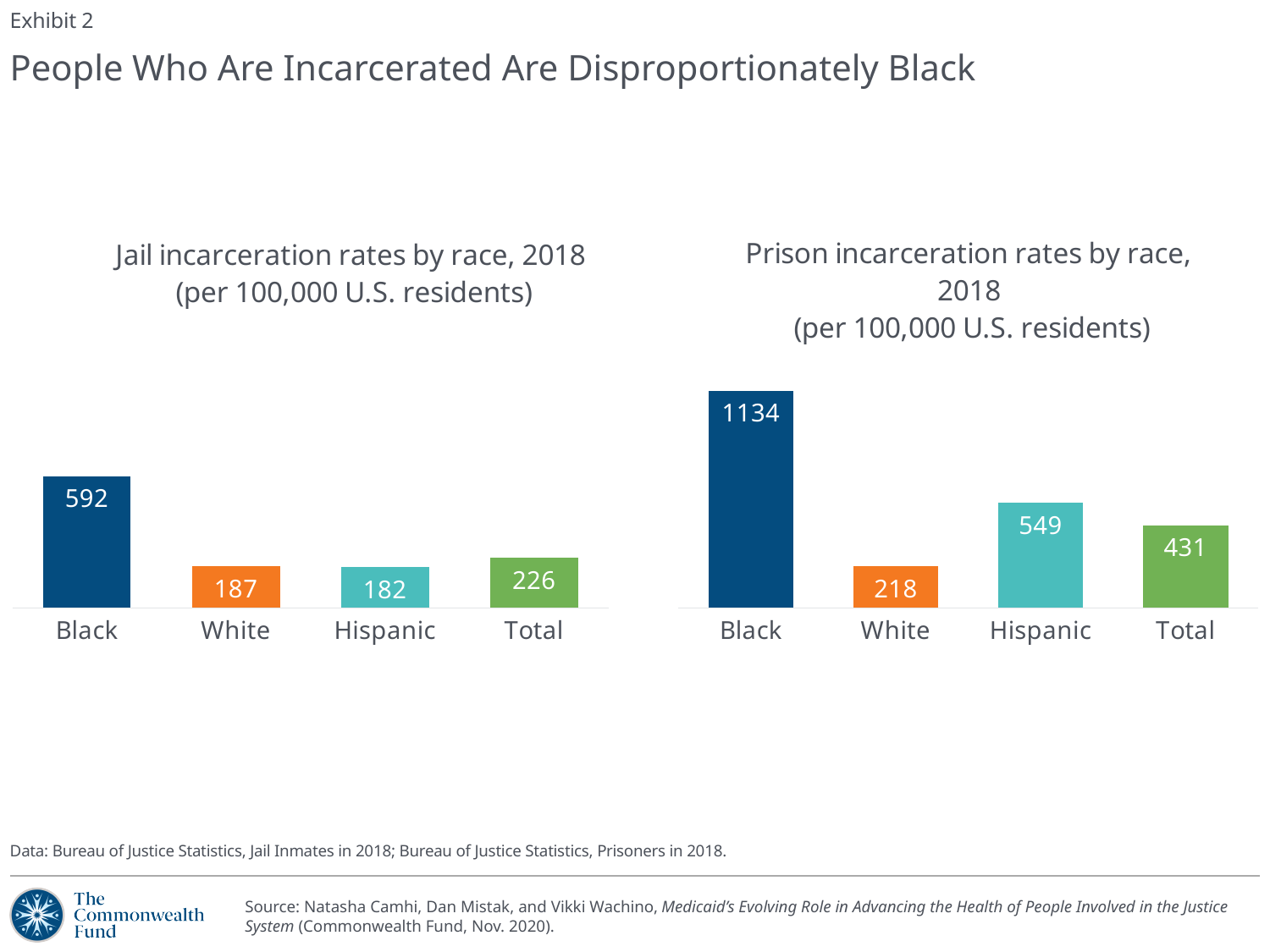
In the prison incarceration rates chart, which is larger, the value for Hispanic or the value for Total? Hispanic In the prison incarceration rates chart, which category has the highest value? Black In the prison incarceration rates chart, which category has the lowest value? White In the prison incarceration rates chart, what is the value for Hispanic? 549 In the prison incarceration rates chart, what is the difference between the values for Black and White? 916 In the jail incarceration rates chart, which category has the lowest value? Hispanic What is the title of the chart on the left side of the slide? Jail incarceration rates by race, 2018 (per 100,000 U.S. residents) In the jail incarceration rates chart, what is the difference between the values for Black and Total? 366 In the jail incarceration rates chart, what is the value for Black? 592 How many categories are shown in the jail incarceration rates chart? 4 In the jail incarceration rates chart, what is the value for Total? 226 What kind of chart is the prison incarceration rates chart? Bar chart